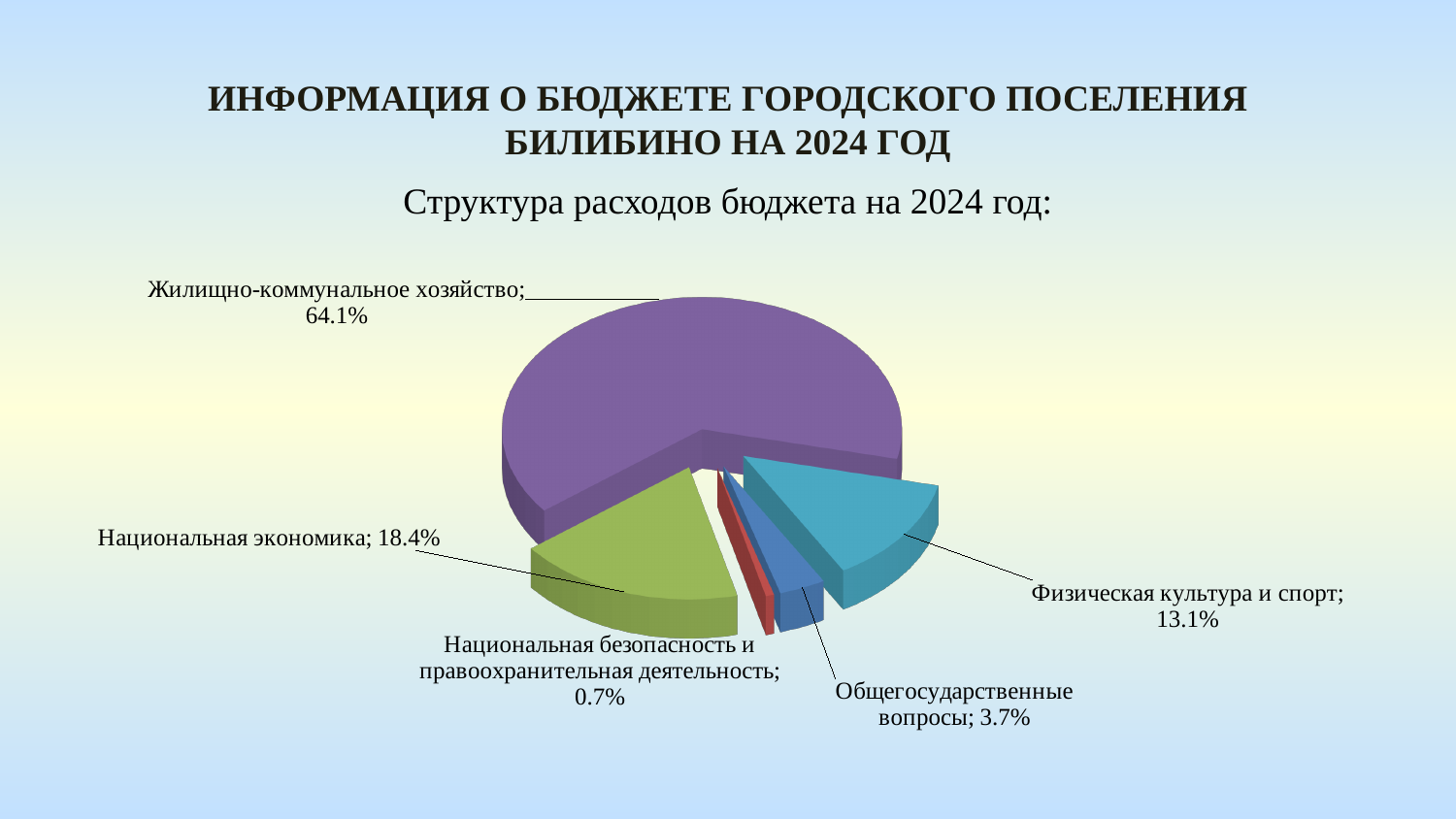
What is the value shown for Национальная экономика? 18.4% What is the value shown for Национальная безопасность и правоохранительная деятельность? 0.7% What is the difference between the shares of Национальная экономика and Физическая культура и спорт? 5.3% What kind of chart is shown on the slide? Pie chart Which category has the largest share of the pie? Жилищно-коммунальное хозяйство How many categories are shown in the pie chart? 5 Which category has the smallest share of the pie? Национальная безопасность и правоохранительная деятельность What is the value shown for Физическая культура и спорт? 13.1% What share of the pie does Жилищно-коммунальное хозяйство have? 64.1% Which is larger: the share of Физическая культура и спорт or Общегосударственные вопросы? Физическая культура и спорт What is the value shown for Общегосударственные вопросы? 3.7% What is the subtitle above the chart? Структура расходов бюджета на 2024 год: